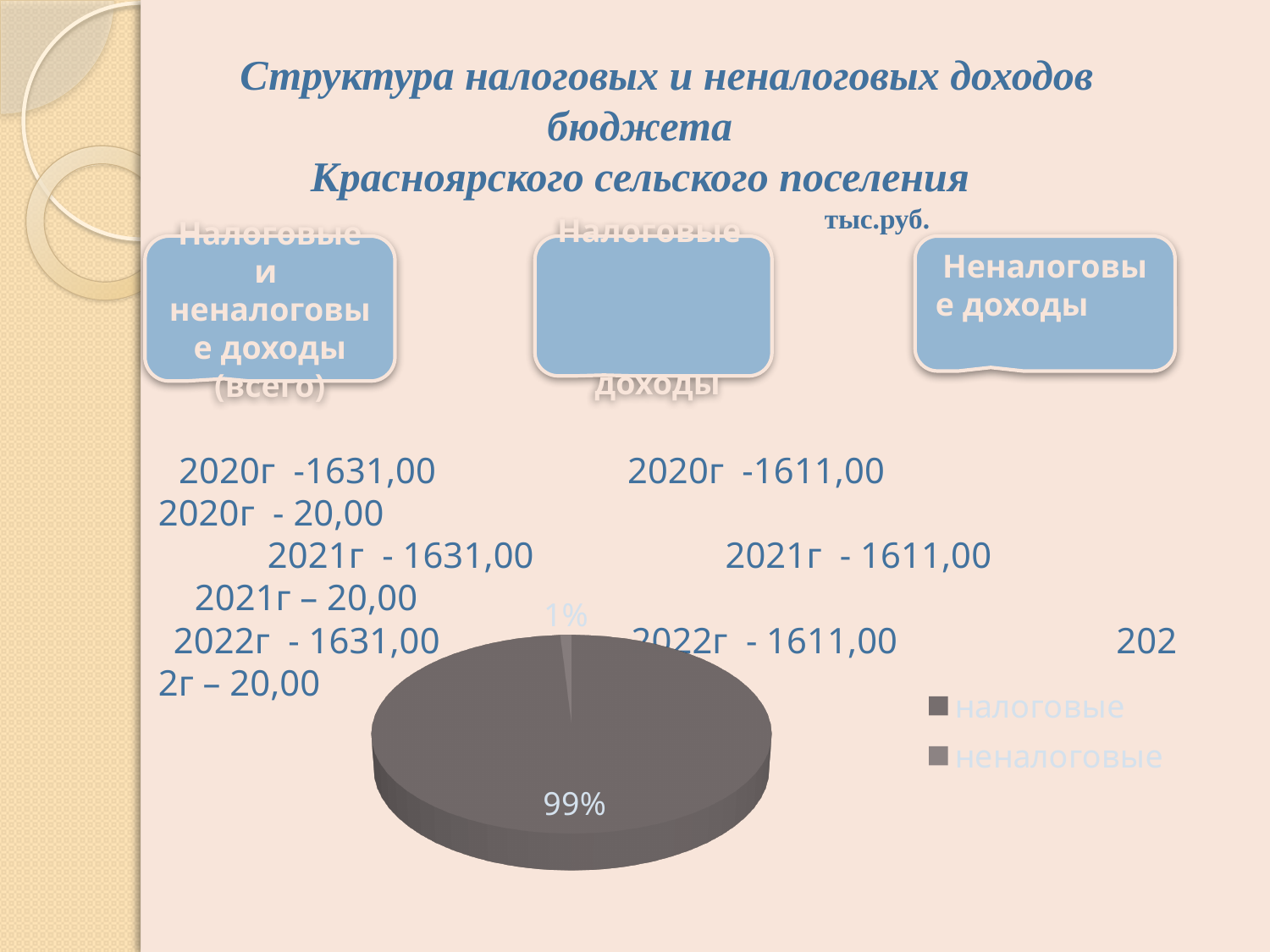
What share of the pie does the 'неналоговые' slice take? 1% Which slice of the pie chart is the smallest? неналоговые What share of the pie does the 'налоговые' slice take? 99% What kind of chart is shown on the slide? pie chart How many entries does the pie chart's legend list? 2 What are the two legend entries of the pie chart? налоговые, неналоговые Which slice of the pie chart is the largest? налоговые What unit is stated for the figures on the slide? тыс.руб. Which is larger in the pie chart, 'налоговые' or 'неналоговые'? налоговые How many slices does the pie chart have? 2 What is the difference in percentage points between the 'налоговые' and 'неналоговые' slices? 98